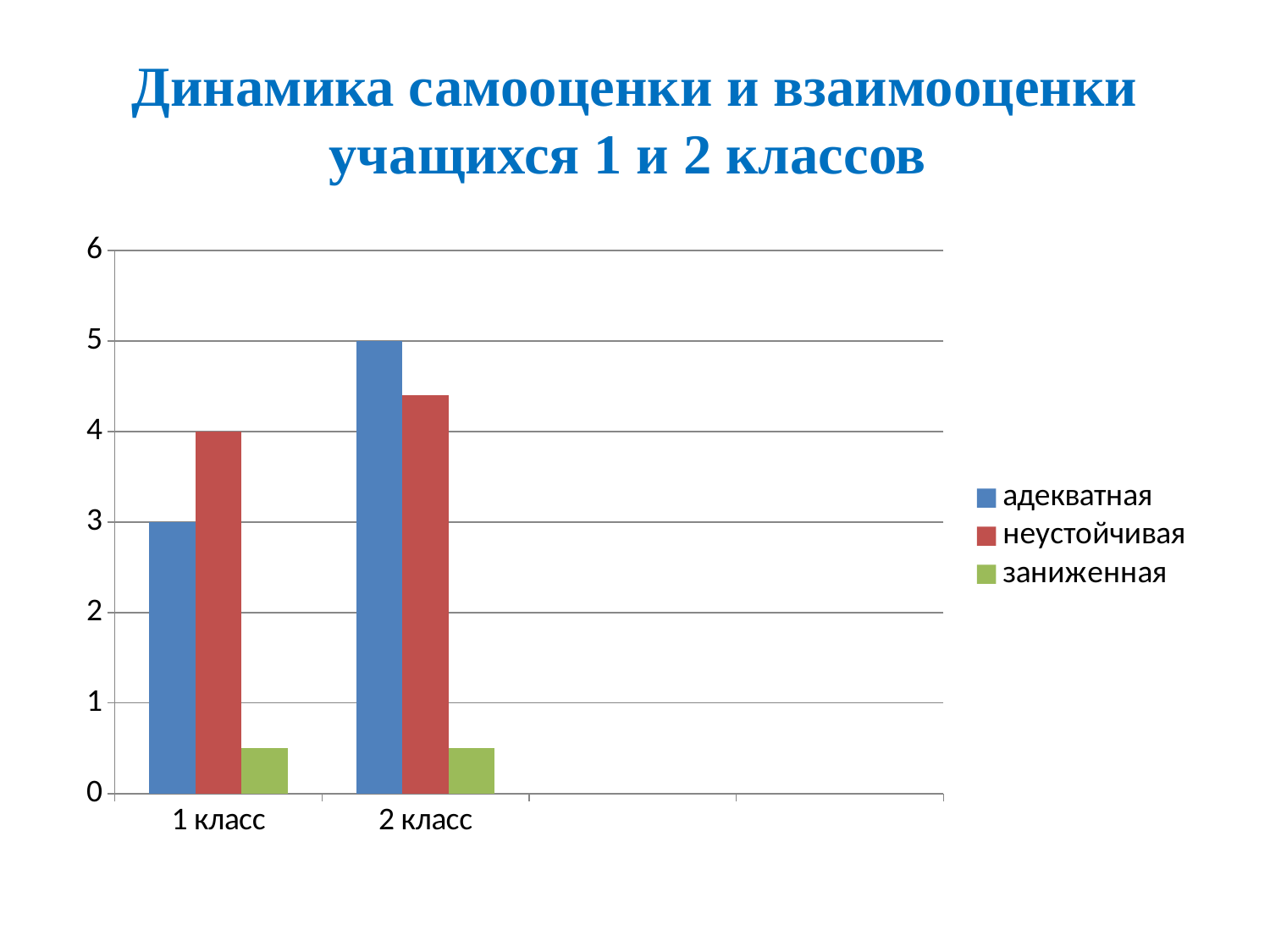
Is the value for неустойчивая in 2 класс greater or less than 4? greater What is the value for адекватная in 2 класс? 5 How many series does the legend list? 3 Which series has the lowest value in 1 класс? заниженная Does the адекватная value rise or fall from 1 класс to 2 класс? rise What is the value for неустойчивая in 1 класс? 4 What kind of chart is shown on the slide? bar chart What is the difference between the адекватная values for 2 класс and 1 класс? 2 Which series has the highest value in 2 класс? адекватная How many categories are shown on the x axis? 2 Is the value for заниженная in 1 класс greater or less than 1? less What is the value for адекватная in 1 класс? 3